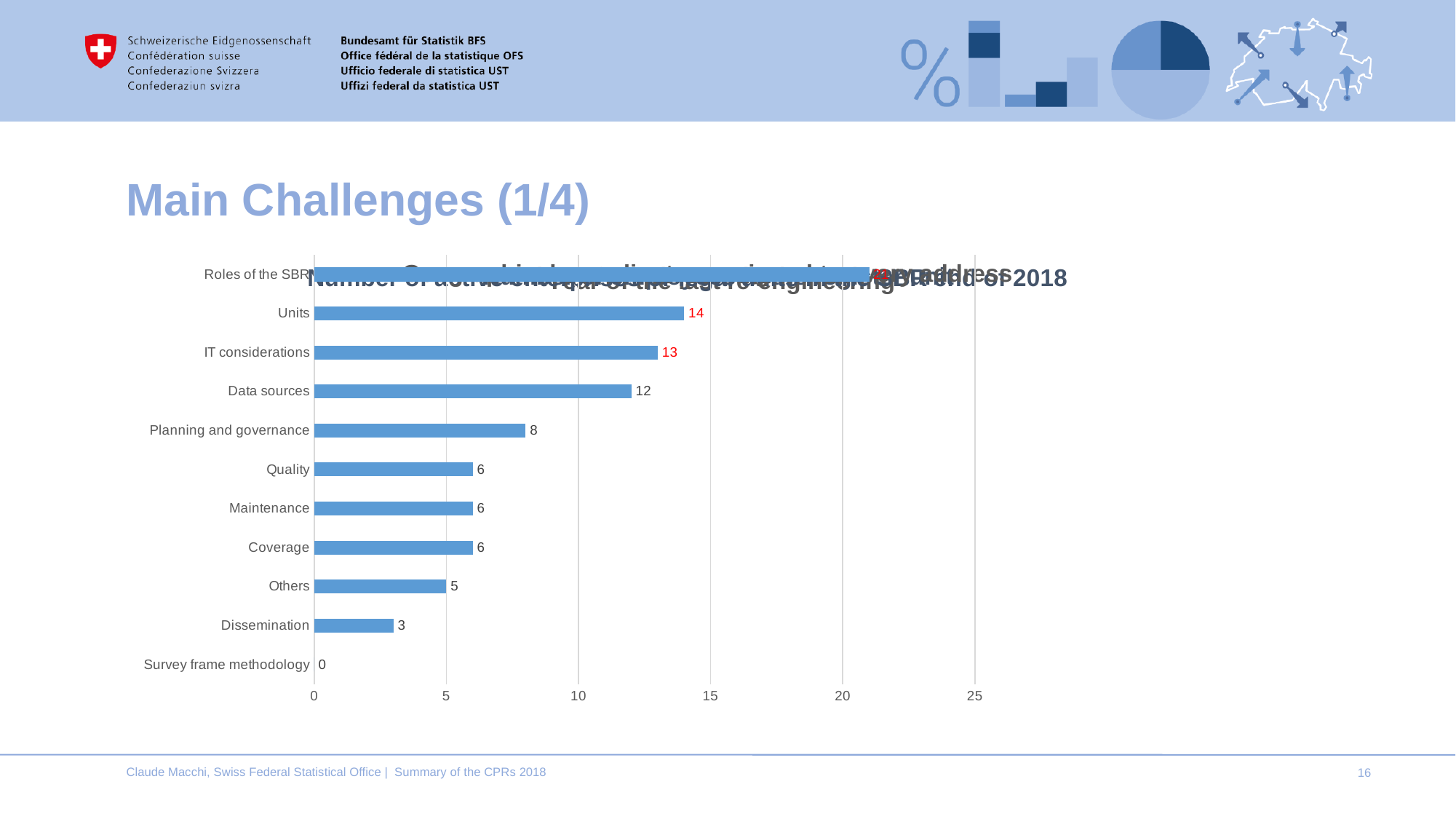
What is the difference between the values for Units and Others? 9 What is the value for Dissemination? 3 What is the value for IT considerations? 13 What kind of chart is shown on the slide? bar chart What is the value for Planning and governance? 8 Which category has the highest value? Roles of the SBR What is the value for Units? 14 How many categories are shown in the chart? 11 Is the value for Roles of the SBR greater or less than 15? greater What is the value for Data sources? 12 Which is larger, the value for Data sources or the value for Planning and governance? Data sources Which category has the lowest value? Survey frame methodology